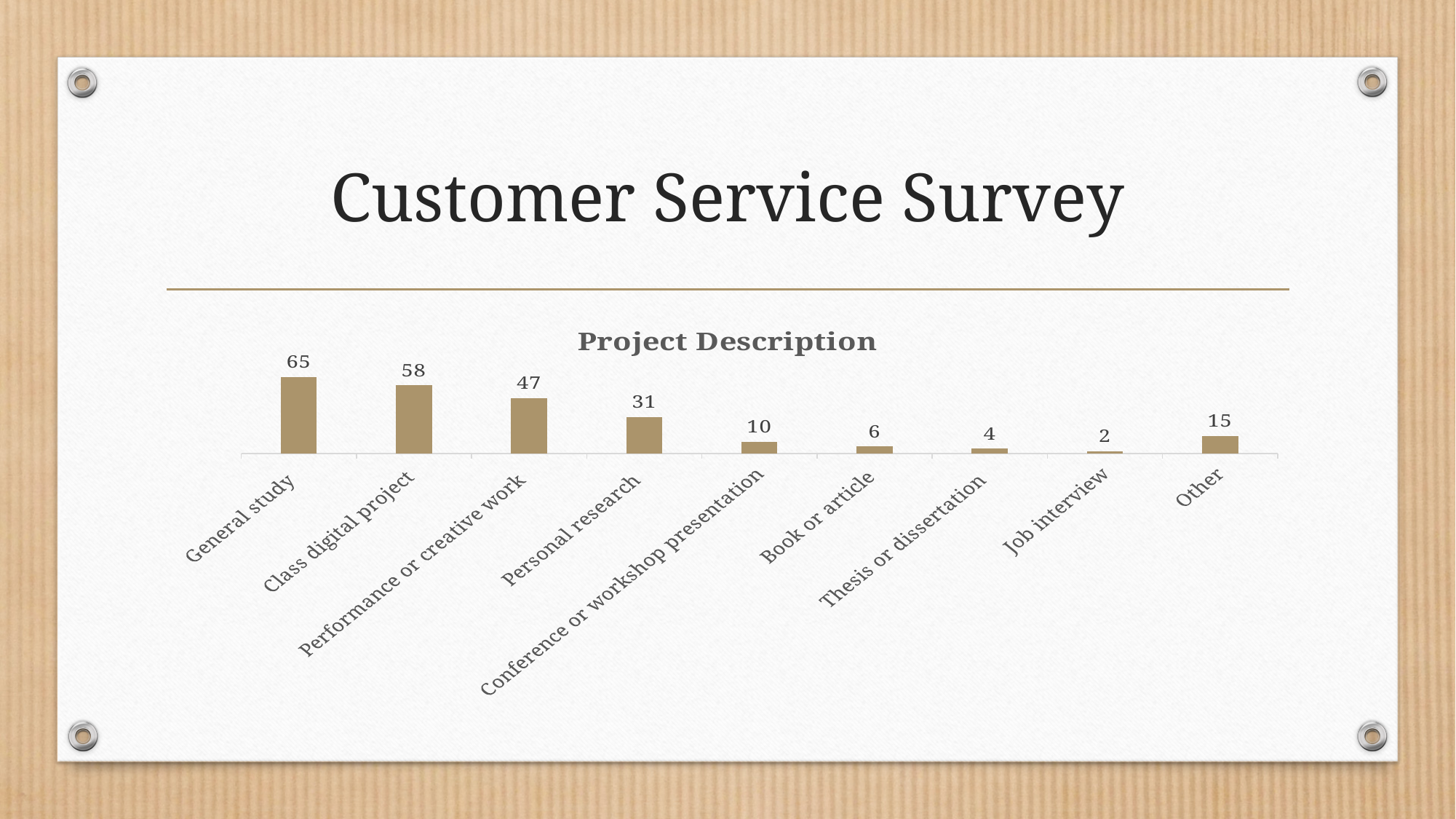
What is the title of the chart? Project Description What is the value for General study? 65 Which category has the lowest value? Job interview Which category has the highest value? General study What is the value for Other? 15 How many categories are shown in the chart? 9 Which is larger, the value for Book or article or the value for Other? Other What is the difference between the values for Performance or creative work and Personal research? 16 What is the value for Conference or workshop presentation? 10 What kind of chart is shown on the slide? Bar chart What is the value for Thesis or dissertation? 4 What is the difference between the values for General study and Class digital project? 7